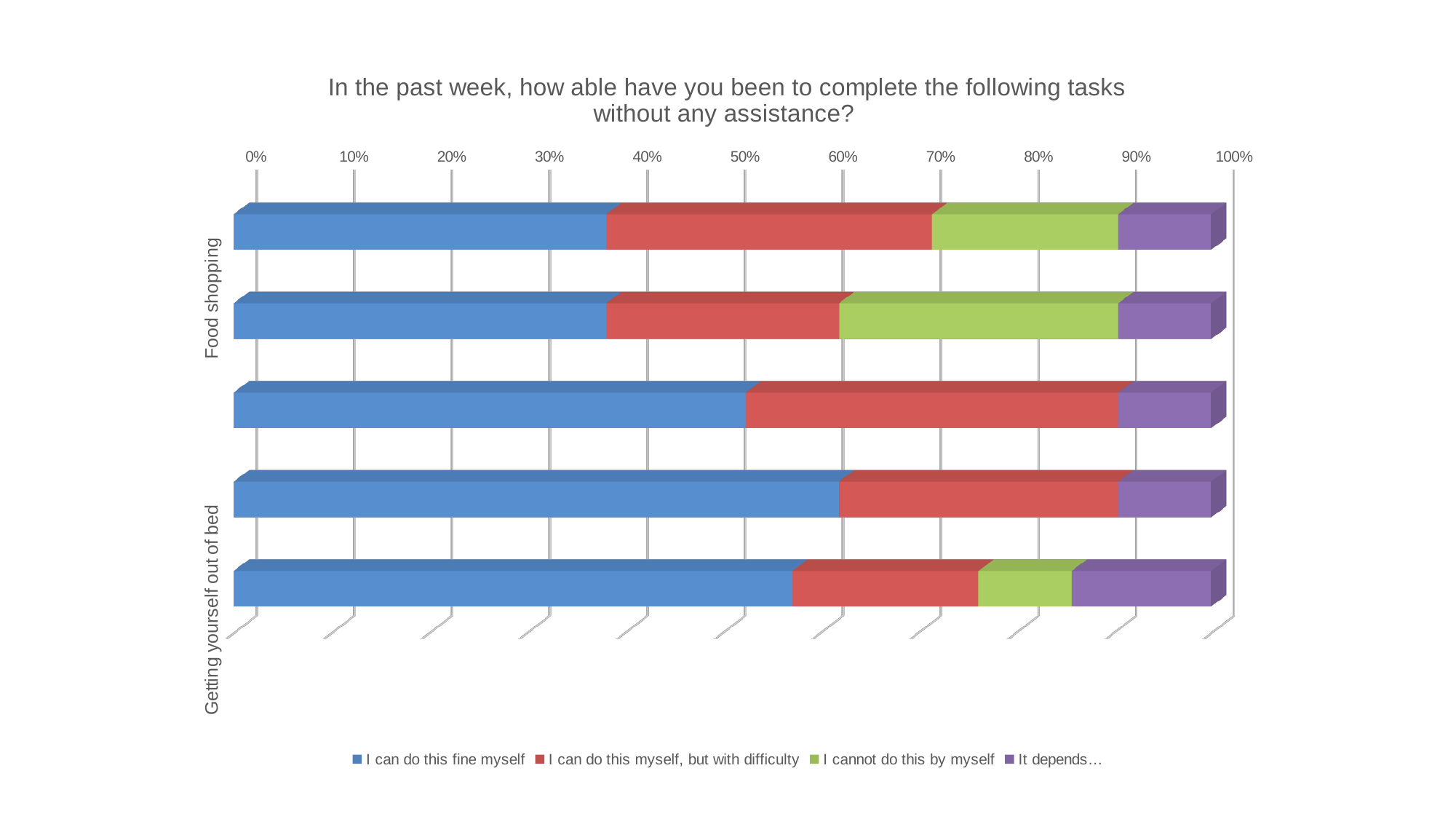
What is the title of the chart? In the past week, how able have you been to complete the following tasks without any assistance? How many series does the legend list? 4 In the top bar, is the 'I can do this fine myself' segment greater or less than 40%? less What kind of chart is shown on the slide? Stacked bar chart What is the maximum value shown on the horizontal axis? 100% In the bottom bar, is the 'I can do this fine myself' segment greater or less than 50%? greater How many bars are plotted in the chart? 5 Which legend entry is shown in blue? I can do this fine myself Is the 'I can do this fine myself' segment larger in the top bar or the bottom bar? the bottom bar